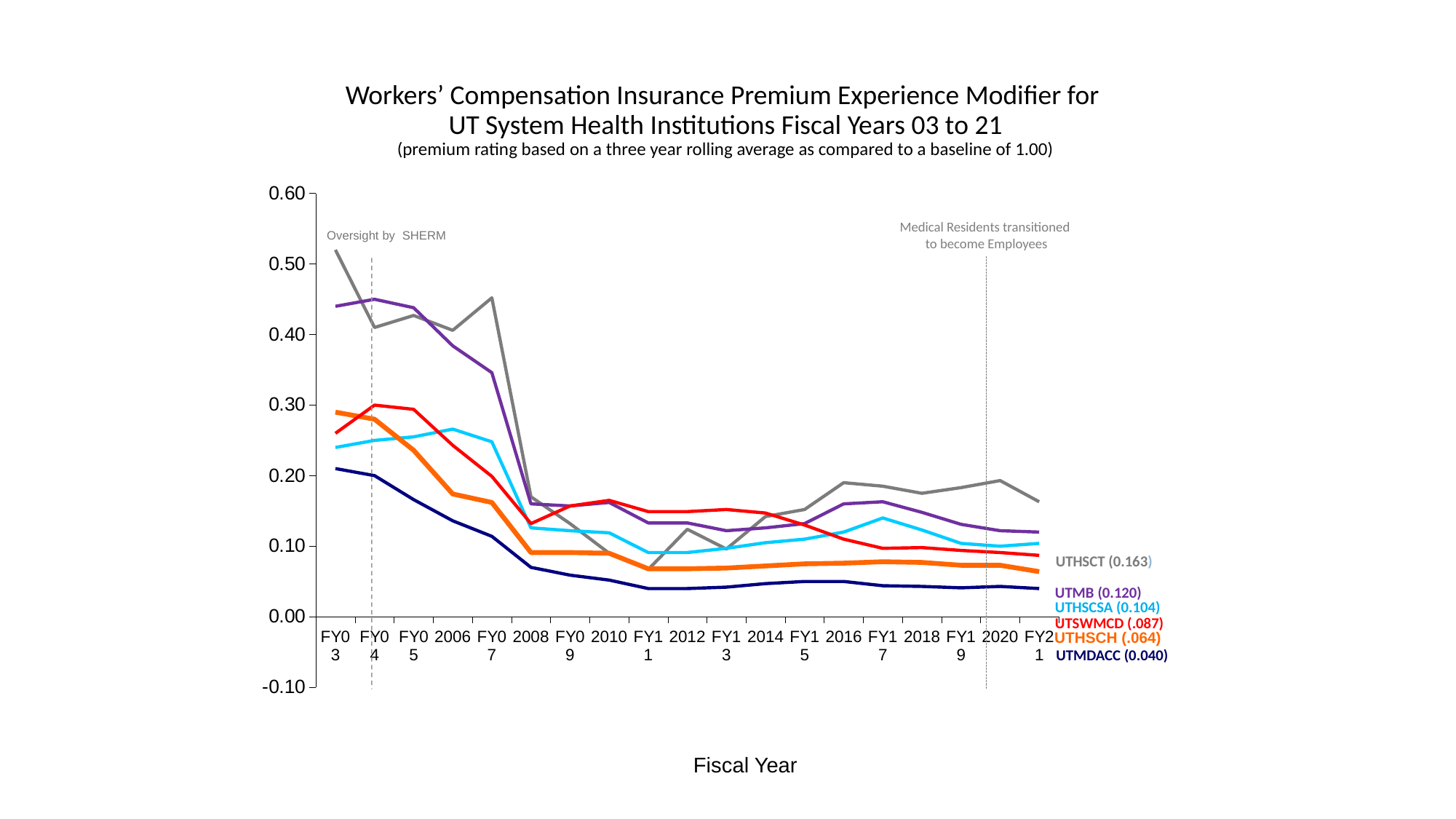
In FY21, which has the larger value, UTMB or UTHSCSA? UTMB Does the UTMDACC line rise or fall from FY03 to FY21? Fall What is the FY21 experience modifier value shown for UTMDACC? 0.040 How many institutions (series) are plotted on the chart? 6 What is the FY21 value shown for UTHSCH? .064 Is the value for UTHSCT in FY03 greater or less than 0.50? greater What is the label of the x axis? Fiscal Year What is the FY21 experience modifier value shown for UTHSCT? 0.163 Which institution has the lowest experience modifier in FY21? UTMDACC What is the difference between the FY21 values of UTHSCT and UTMDACC? 0.123 What kind of chart is shown on the slide? Line chart Which institution has the highest experience modifier in FY21? UTHSCT